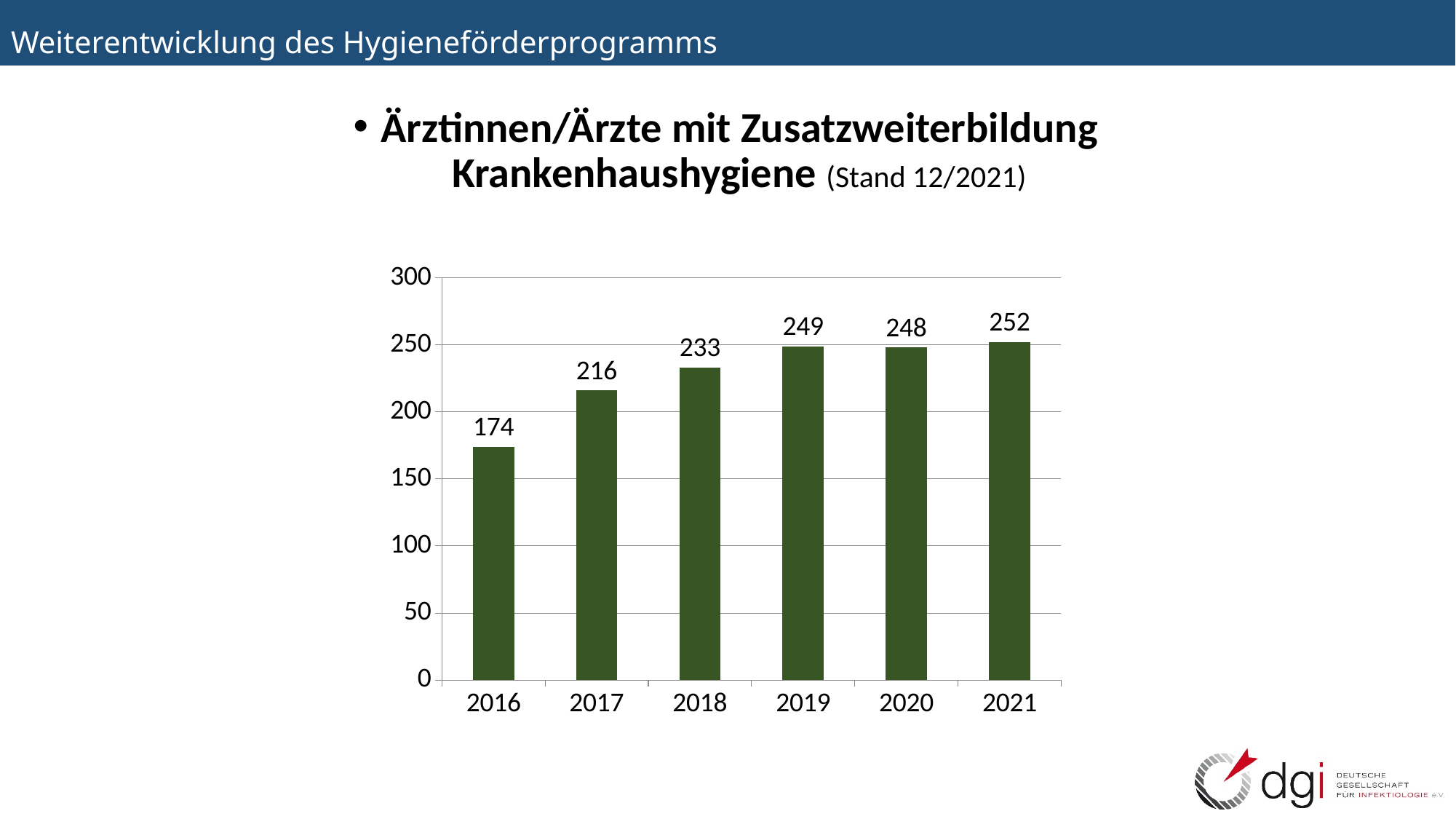
What is the difference between the values for 2018 and 2017? 17 Do the values generally rise or fall from 2016 to 2021? rise Which year has the lowest value? 2016 Which year has the highest value? 2021 What is the value for 2021? 252 Is the value for 2016 greater or less than 200? less What is the value for 2016? 174 What kind of chart is shown on the slide? bar chart Which is larger, the value for 2017 or the value for 2018? 2018 What is the difference between the values for 2021 and 2016? 78 How many years are shown on the x axis? 6 What is the value for 2019? 249